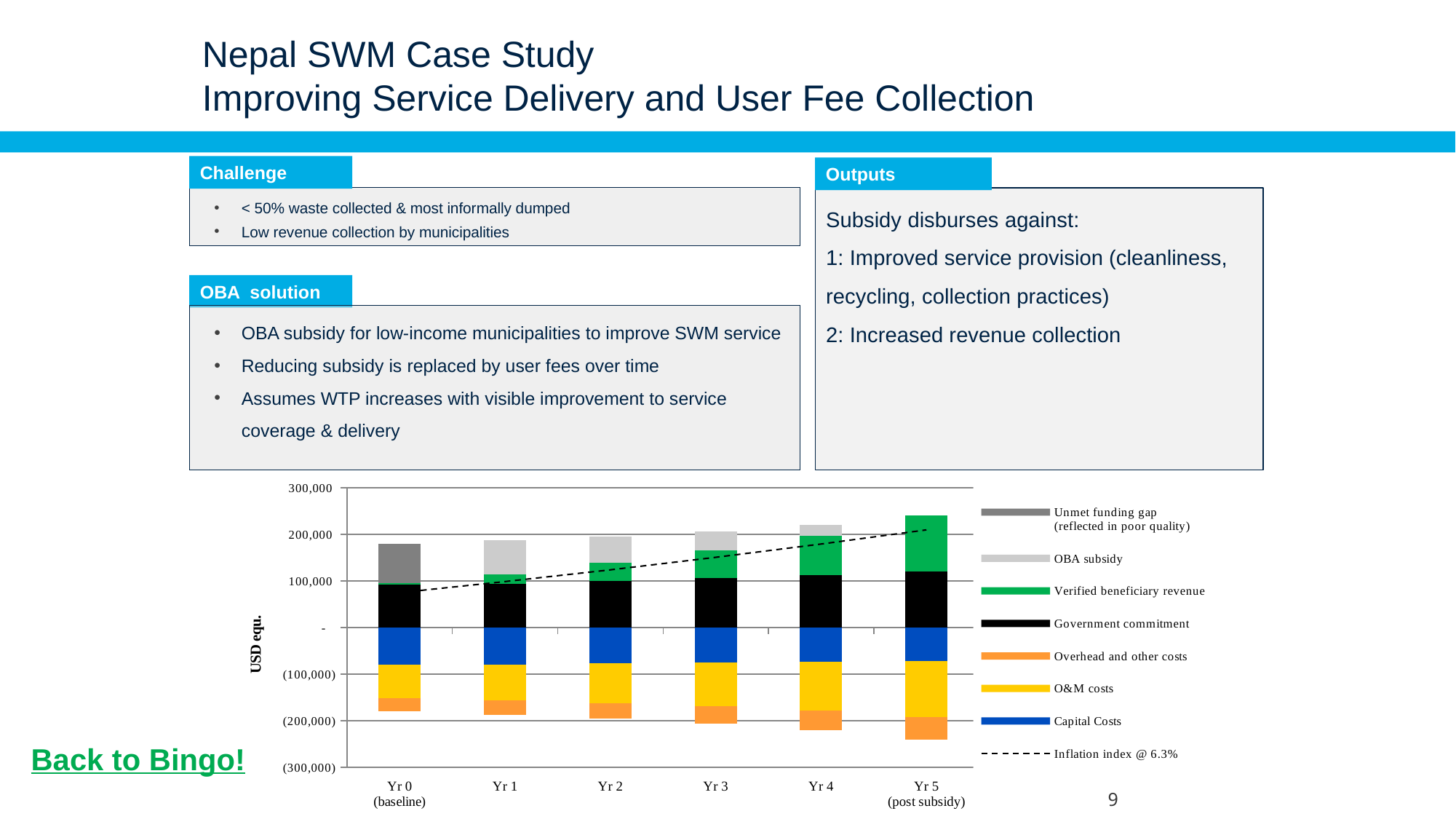
Which year has the larger Verified beneficiary revenue segment, Yr 1 or Yr 5? Yr 5 What inflation rate is stated in the legend for the dashed line? 6.3% Is the top of the positive stack for Yr 5 (post subsidy) greater or less than 200,000? greater What is the label on the vertical axis of the chart? USD equ. Does the Inflation index dashed line rise or fall from Yr 0 to Yr 5? rise Does the Verified beneficiary revenue segment rise or fall from Yr 1 to Yr 5? rise How many year categories are shown on the x axis of the chart? 6 Is the Government commitment segment for Yr 1 greater or less than 200,000? less Which year is the only one showing an Unmet funding gap segment? Yr 0 (baseline) What type of chart is shown on the slide? Stacked bar chart Is the top of the positive stack for Yr 0 (baseline) greater or less than 200,000? less How many entries does the chart legend list? 8